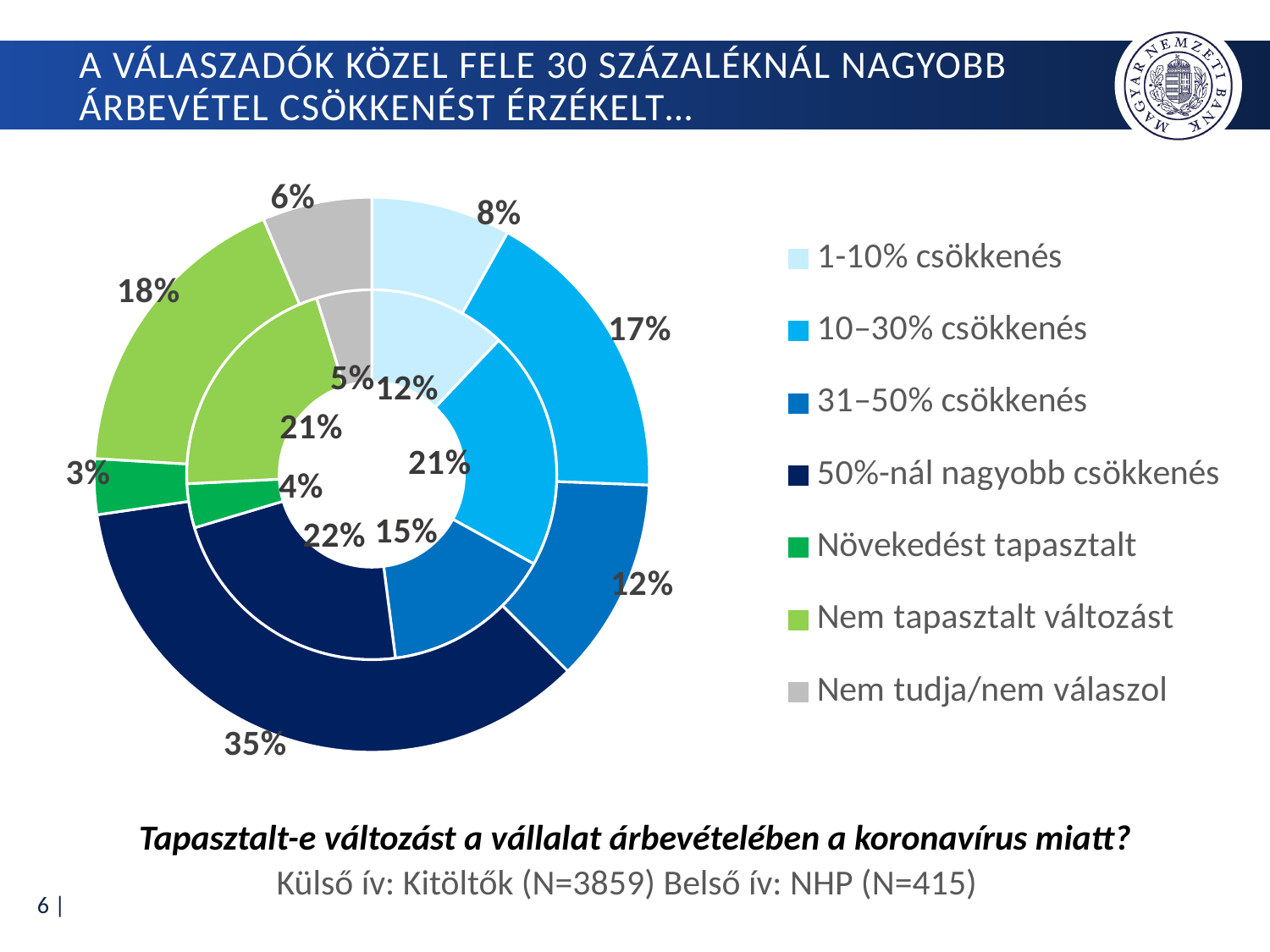
In the outer ring (Kitöltők), which category has the largest share? 50%-nál nagyobb csökkenés According to the note below the chart, what is the sample size (N) for the outer ring (Kitöltők)? N=3859 In the outer ring (Kitöltők), what share is labelled for '50%-nál nagyobb csökkenés'? 35% In the inner ring (NHP), what share is labelled for '50%-nál nagyobb csökkenés'? 22% What is the difference between the outer-ring and inner-ring shares for '50%-nál nagyobb csökkenés'? 13 percentage points In the inner ring (NHP), which category has the smallest share? Növekedést tapasztalt What kind of chart is shown on the slide? Doughnut chart In the outer ring (Kitöltők), what share is labelled for '10–30% csökkenés'? 17% How many entries does the legend list? 7 Which is larger: the outer-ring share for 'Nem tapasztalt változást' or the outer-ring share for '31–50% csökkenés'? Nem tapasztalt változást In the inner ring (NHP), what share is labelled for '1-10% csökkenés'? 12% In the outer ring (Kitöltők), which category has the smallest share? Növekedést tapasztalt